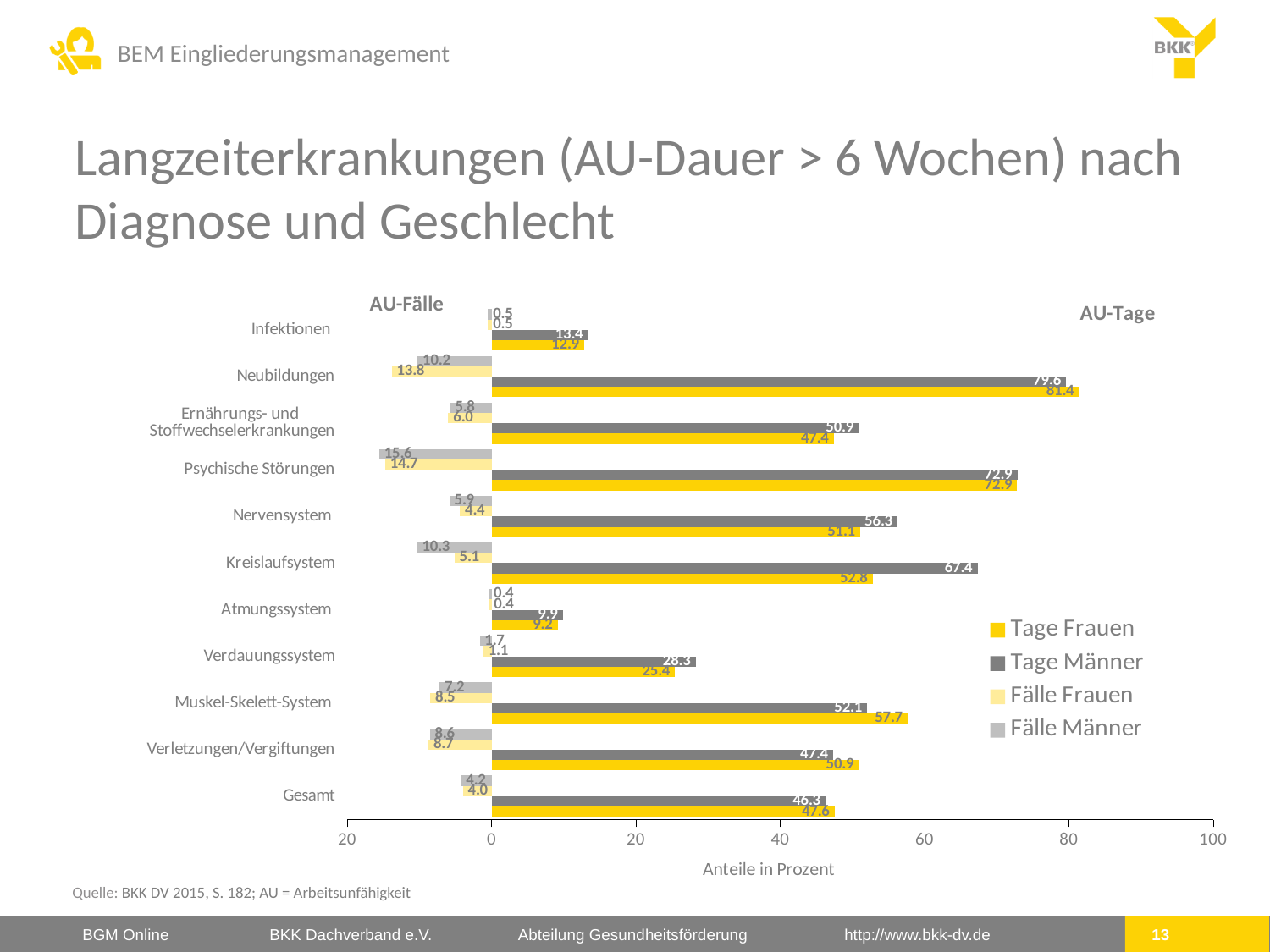
Which is larger for Muskel-Skelett-System: Tage Frauen or Tage Männer? Tage Frauen What is the x-axis label of the chart? Anteile in Prozent What is the value of Tage Frauen for Neubildungen? 81.4 What is the difference between Tage Männer and Tage Frauen for Kreislaufsystem? 14.6 What is the value of Tage Männer for Kreislaufsystem? 67.4 How many diagnosis categories are shown on the chart? 11 How many series does the legend list? 4 What is the value of Fälle Männer for Psychische Störungen? 15.6 Which diagnosis has the highest Tage Frauen value? Neubildungen What is the value of Fälle Frauen for Muskel-Skelett-System? 8.5 What kind of chart is shown on the slide? Bar chart Which diagnosis has the lowest Tage Männer value? Atmungssystem